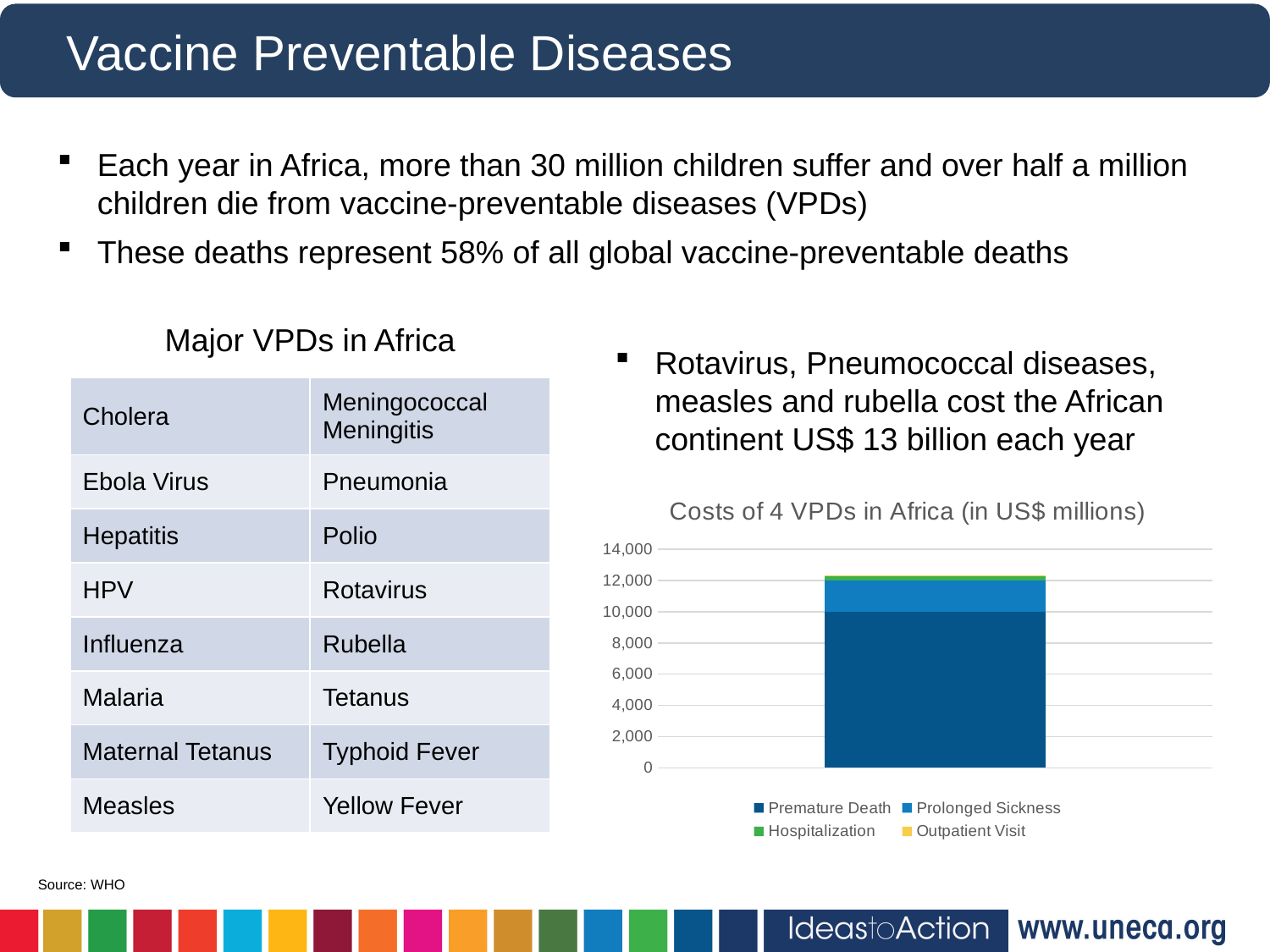
How many series does the chart's legend list? 4 What is the title of the chart on the slide? Costs of 4 VPDs in Africa (in US$ millions) How many bars are plotted in the chart? 1 Which series in the chart is shown in green? Hospitalization Is the value for Premature Death greater or less than 8,000? greater Is the total height of the stacked bar greater or less than 10,000? greater Which series makes up the largest part of the stacked bar? Premature Death Is the total height of the stacked bar greater or less than 14,000? less Which is larger in the chart, the Premature Death segment or the Prolonged Sickness segment? Premature Death What is the highest value shown on the chart's vertical axis? 14,000 What kind of chart is shown on the slide? Stacked bar chart